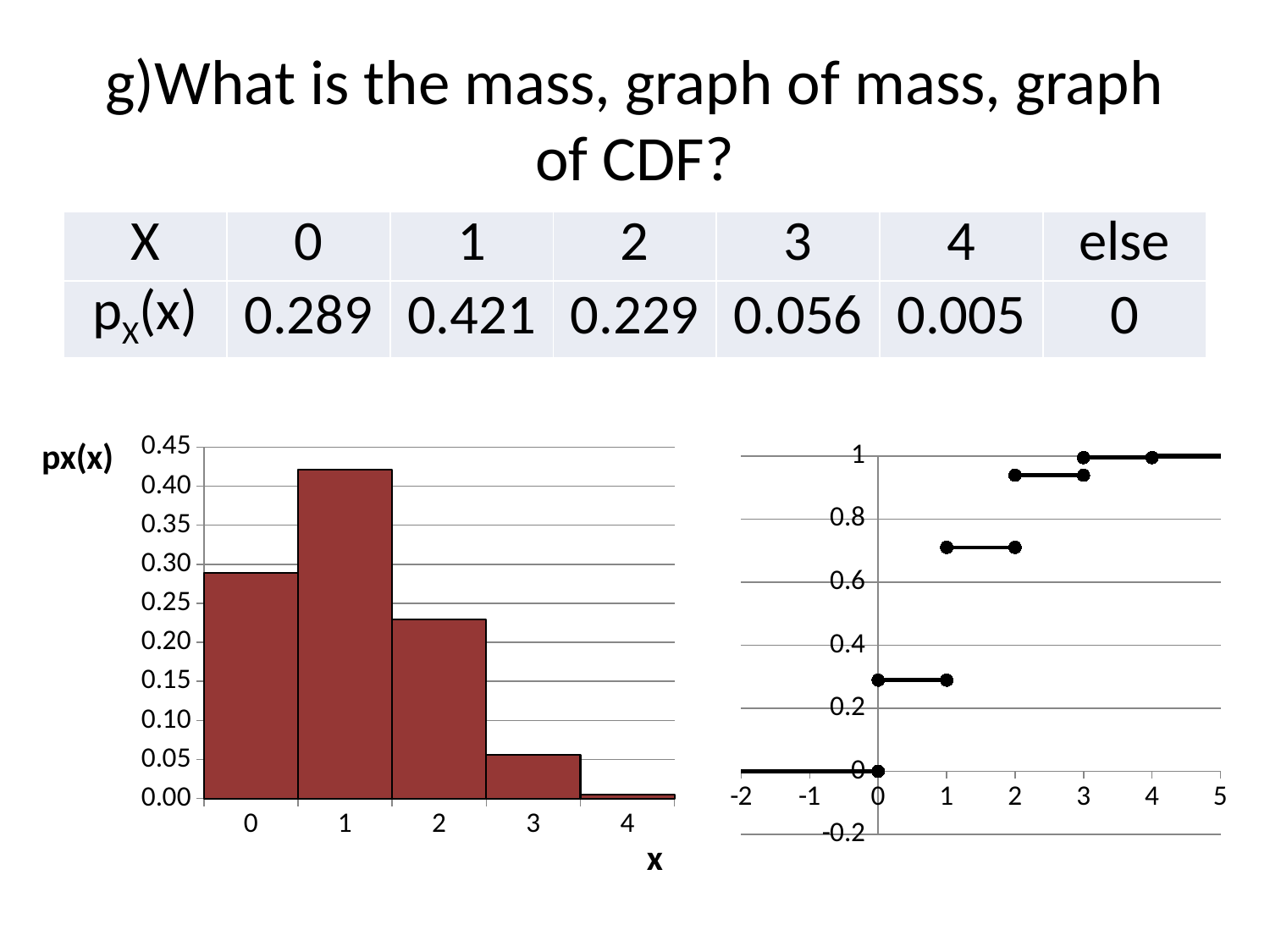
In the chart on the right (the CDF graph), is the value of the step between x = 1 and x = 2 greater or less than 0.6? greater In the bar chart on the left, what is the difference between px(x) at x = 1 and at x = 0? 0.132 In the bar chart on the left, which value of x has the tallest bar? 1 In the bar chart on the left, is the bar for x = 2 greater or less than 0.25? less In the bar chart on the left, what is the value of px(x) at x = 3? 0.056 In the chart on the right (the CDF graph), do the plotted values rise or fall as x increases? rise In the bar chart on the left, which bar is taller, x = 0 or x = 2? x = 0 In the bar chart on the left, is the bar for x = 0 greater or less than 0.25? greater In the bar chart on the left, which value of x has the shortest bar? 4 What kind of chart is the chart on the left of the slide? bar chart In the bar chart on the left, how many bars (categories) are plotted? 5 In the bar chart on the left, what is the value of px(x) at x = 1? 0.421